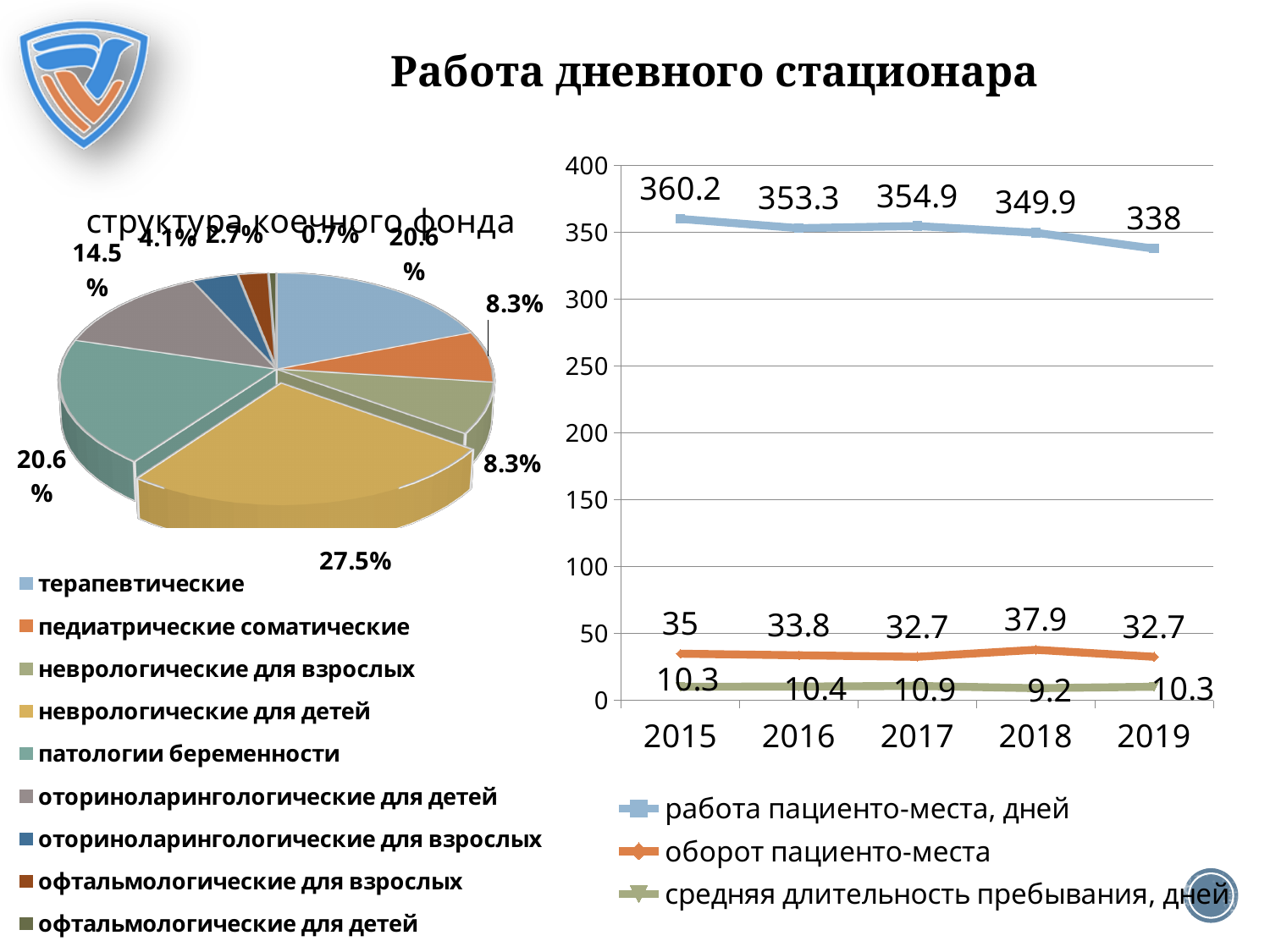
In the pie chart 'структура коечного фонда', what share do 'неврологические для детей' beds have? 27.5% In the line chart on the right, does 'работа пациенто-места, дней' generally rise or fall from 2015 to 2019? fall In the line chart on the right, what is the difference between 'работа пациенто-места, дней' in 2015 and in 2019? 22.2 In the line chart on the right, what is the value of 'оборот пациенто-места' in 2018? 37.9 In the line chart on the right, in which year is 'средняя длительность пребывания, дней' lowest? 2018 In the pie chart 'структура коечного фонда', which category has the smallest share? офтальмологические для детей In the line chart on the right, what is the value of 'средняя длительность пребывания, дней' in 2017? 10.9 In the line chart on the right, in which year is 'работа пациенто-места, дней' highest? 2015 In the line chart on the right, how many series does the legend list? 3 In the line chart on the right, what is the value of 'работа пациенто-места, дней' in 2019? 338 What kind of chart is the chart on the left of the slide? pie chart In the pie chart 'структура коечного фонда', how many categories does the legend list? 9